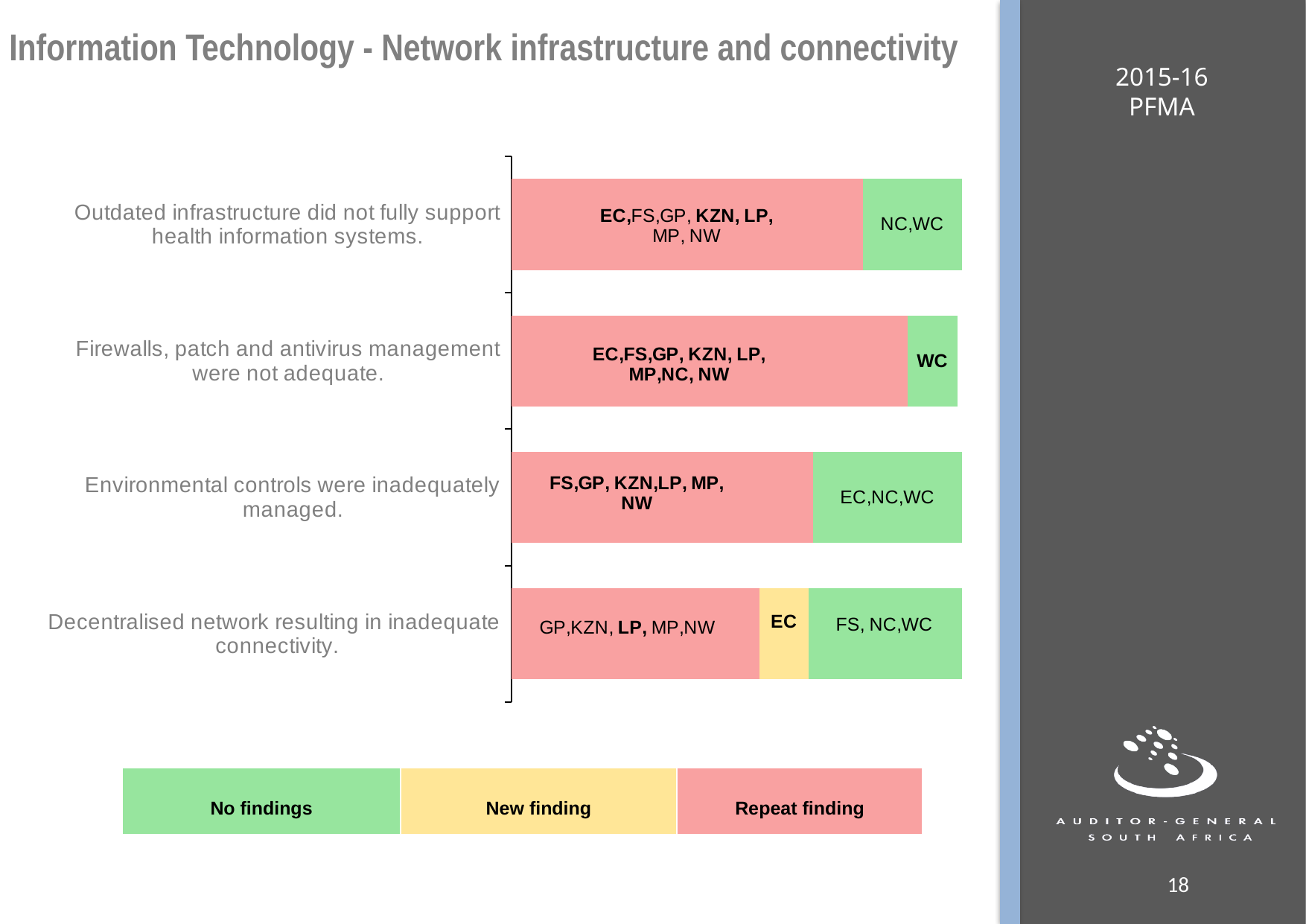
Which provinces are shown in the 'No findings' segment for 'Outdated infrastructure did not fully support health information systems'? NC,WC What type of chart is shown on the slide? Bar chart How many series does the legend list? 3 Which finding has the fewest provinces with no findings? Firewalls, patch and antivirus management were not adequate. What colour represents 'Repeat finding' in the legend? Red Which finding has the largest number of provinces with a repeat finding? Firewalls, patch and antivirus management were not adequate. Which provinces are shown in the 'Repeat finding' segment for 'Decentralised network resulting in inadequate connectivity'? GP,KZN, LP, MP,NW How many findings (categories) are plotted in the chart? 4 Which provinces are shown in the 'No findings' segment for 'Environmental controls were inadequately managed'? EC,NC,WC Which finding is the only one with a 'New finding' segment? Decentralised network resulting in inadequate connectivity. Which province is shown in the 'No findings' segment for 'Firewalls, patch and antivirus management were not adequate'? WC Which province is shown in the 'New finding' segment for 'Decentralised network resulting in inadequate connectivity'? EC